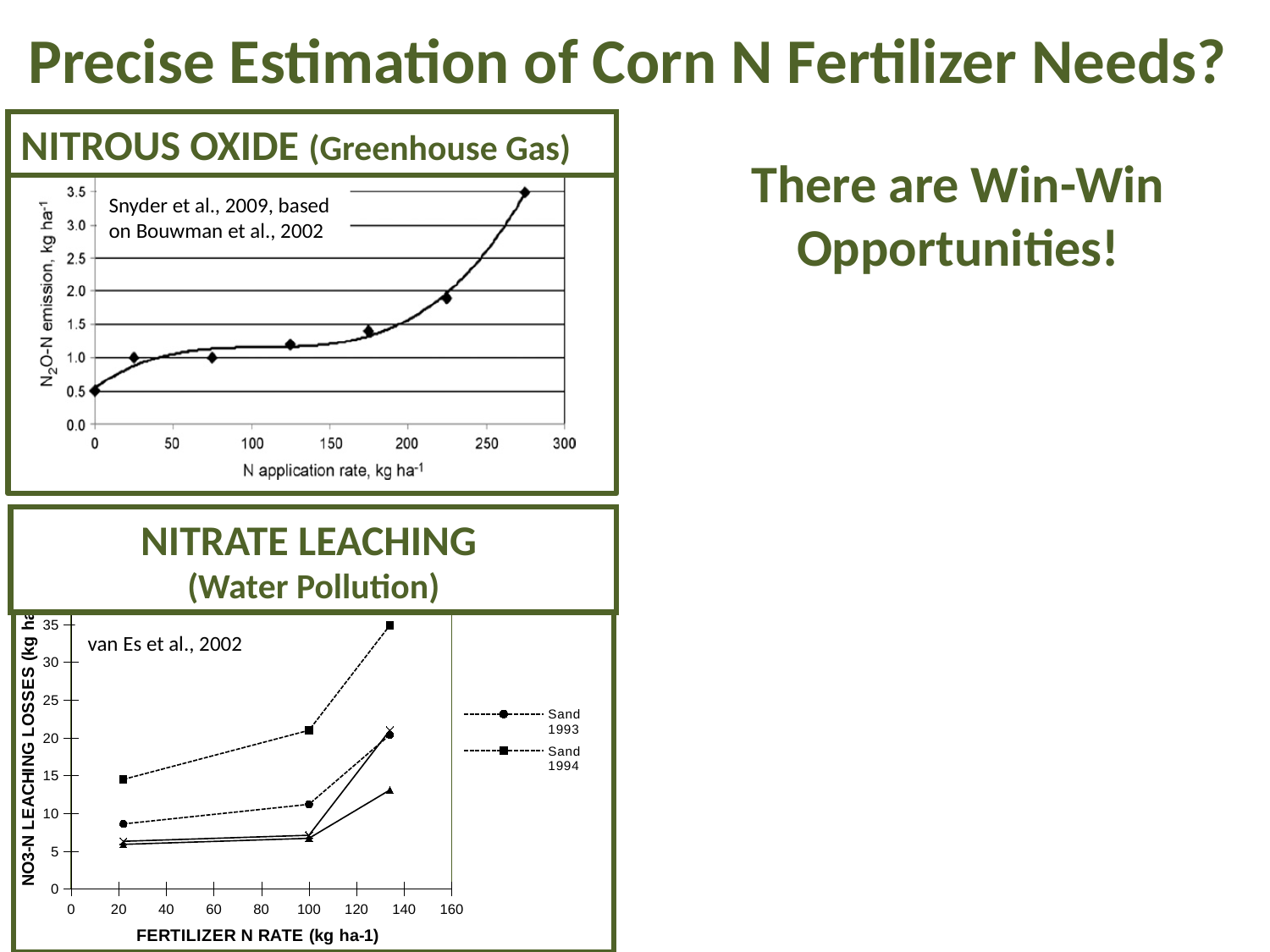
In the Nitrate Leaching chart, do the Sand 1994 leaching losses rise or fall as the fertilizer N rate increases? rise In the Nitrous Oxide chart, is the emission value at the highest N application rate (about 275) greater or less than 3.0? greater In the Nitrous Oxide chart, what kind of chart is shown? line chart In the Nitrous Oxide chart, what is the label of the x axis? N application rate, kg ha-1 In the Nitrate Leaching chart, which source is cited for the data? van Es et al., 2002 In the Nitrous Oxide chart, do N2O-N emissions rise or fall as the N application rate increases? rise In the Nitrate Leaching chart, how many series does the legend list? 2 In the Nitrate Leaching chart, at the highest fertilizer N rate, which is larger: Sand 1993 or Sand 1994? Sand 1994 In the Nitrous Oxide chart, how many data points are plotted? 7 In the Nitrous Oxide chart, is the emission value at an N application rate of 0 greater or less than 1.0? less In the Nitrate Leaching chart, which series reaches the highest leaching loss? Sand 1994 In the Nitrate Leaching chart, at the highest fertilizer N rate, is the Sand 1994 value greater or less than 30? greater